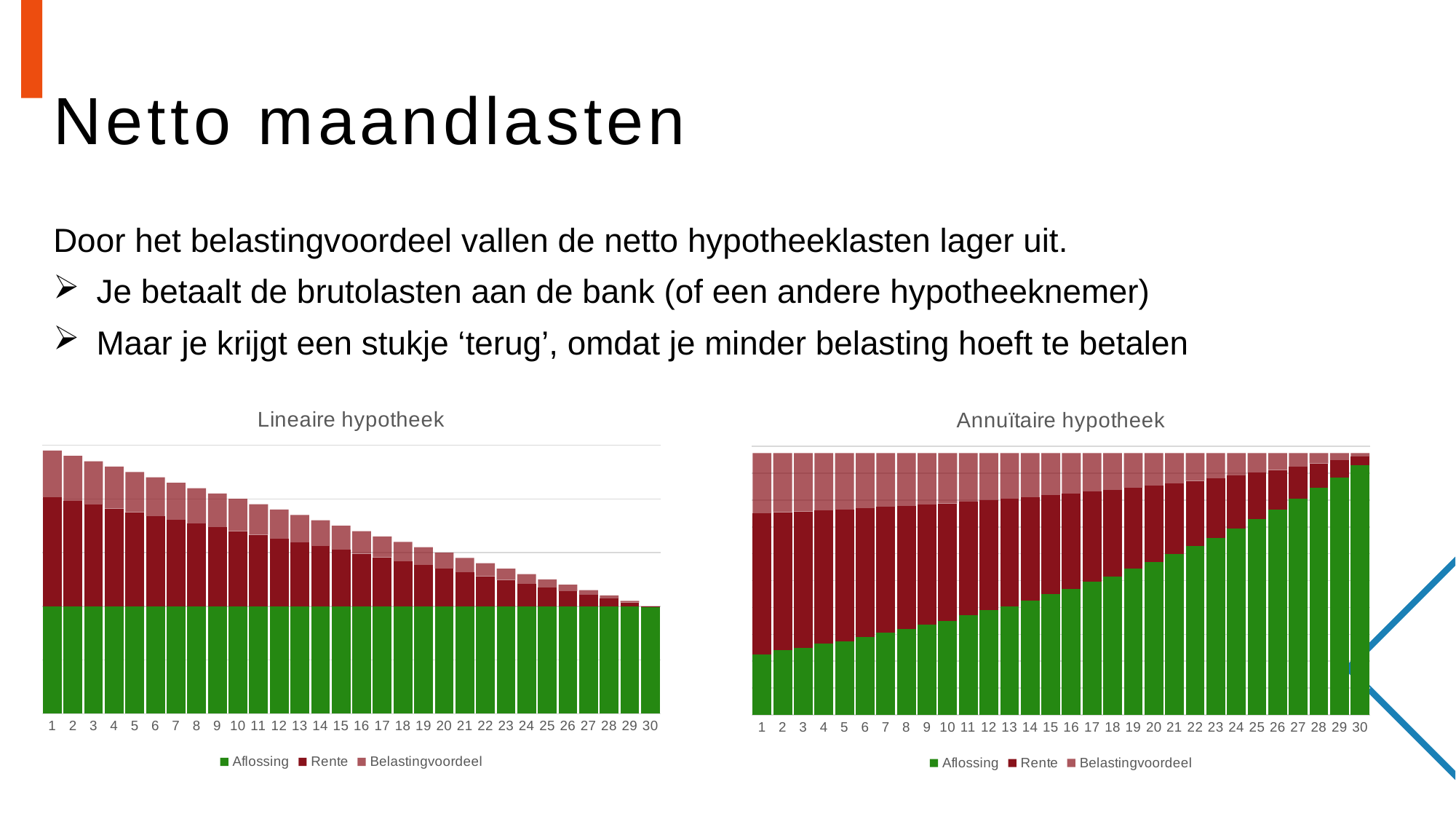
In the 'Lineaire hypotheek' chart, which year has the lowest total stacked bar? 30 In the 'Annuïtaire hypotheek' chart, which is larger in year 30: the Aflossing segment or the Rente segment? Aflossing In the 'Annuïtaire hypotheek' chart, does the Aflossing segment rise or fall from year 1 to year 30? Rise In the 'Annuïtaire hypotheek' chart, which is larger in year 1: the Aflossing segment or the Rente segment? Rente In the 'Lineaire hypotheek' chart, which year has the highest total stacked bar? 1 In the 'Lineaire hypotheek' chart, does the total height of the stacked bars rise or fall from year 1 to year 30? Fall In the 'Annuïtaire hypotheek' chart, does the Rente segment rise or fall from year 1 to year 30? Fall How many categories (years) are shown on the x axis of the 'Lineaire hypotheek' chart? 30 What kind of chart is the 'Lineaire hypotheek' chart? Stacked bar chart What is the title of the chart on the right side of the slide? Annuïtaire hypotheek Which series is shown in green in the 'Lineaire hypotheek' chart? Aflossing How many series does the legend of the 'Annuïtaire hypotheek' chart list? 3